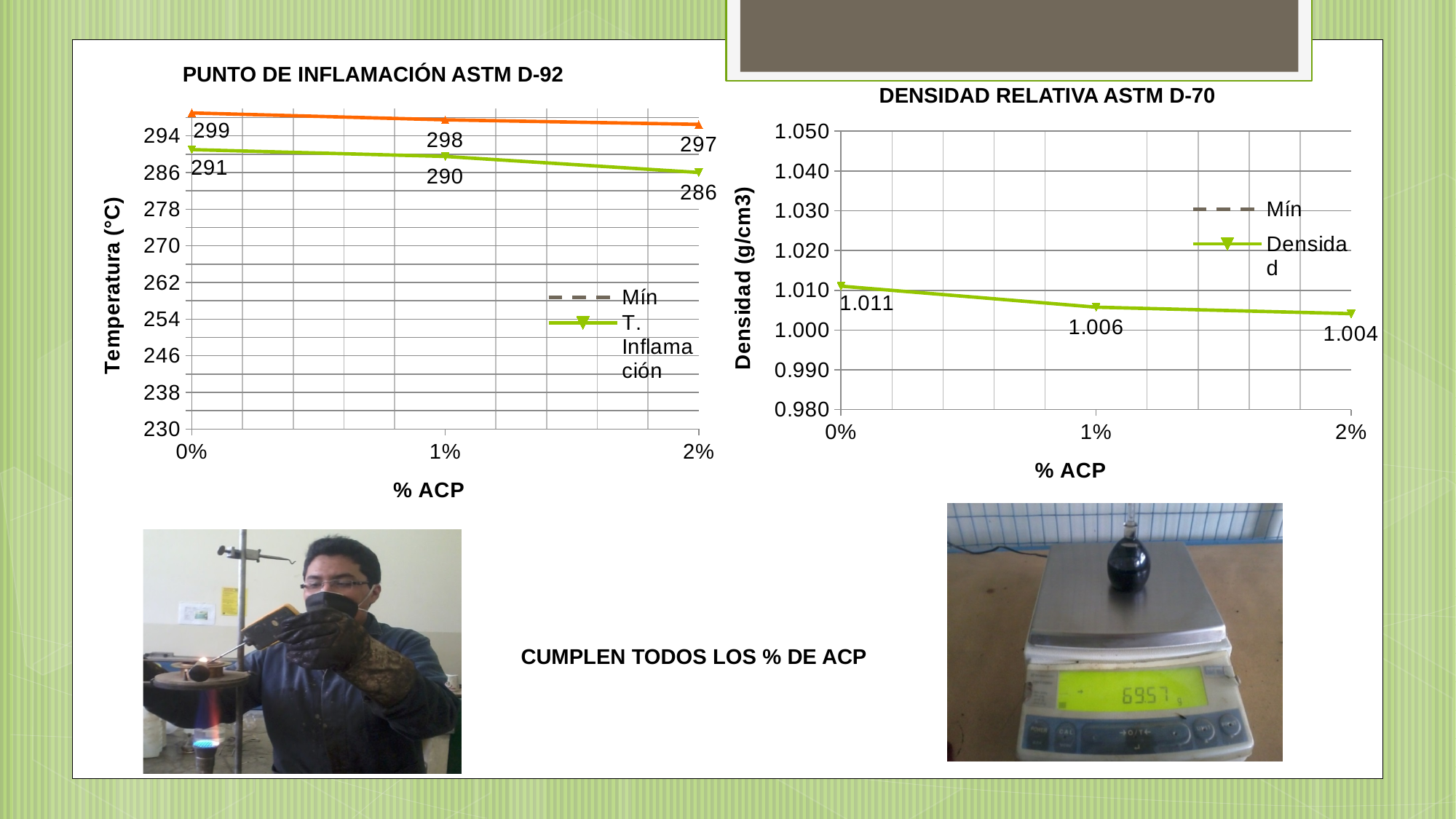
How many series does the legend of the PUNTO DE INFLAMACIÓN ASTM D-92 chart list? 2 In the PUNTO DE INFLAMACIÓN ASTM D-92 chart, what is the T. Inflamación value at 0% ACP? 291 In the DENSIDAD RELATIVA ASTM D-70 chart, what is the difference between the Densidad values at 0% and 2% ACP? 0.007 In the PUNTO DE INFLAMACIÓN ASTM D-92 chart, does the T. Inflamación series rise or fall as % ACP increases? fall In the PUNTO DE INFLAMACIÓN ASTM D-92 chart, what is the T. Inflamación value at 2% ACP? 286 In the DENSIDAD RELATIVA ASTM D-70 chart, at which % ACP is the Densidad value highest? 0% In the DENSIDAD RELATIVA ASTM D-70 chart, what is the Densidad value at 1% ACP? 1.006 In the PUNTO DE INFLAMACIÓN ASTM D-92 chart, what is the difference between the T. Inflamación values at 0% and 2% ACP? 5 In the PUNTO DE INFLAMACIÓN ASTM D-92 chart, at which % ACP is the T. Inflamación value lowest? 2% What type of chart is the DENSIDAD RELATIVA ASTM D-70 chart? line chart In the PUNTO DE INFLAMACIÓN ASTM D-92 chart, what is the value of the upper (orange) line at 1% ACP? 298 How many data points are plotted on the Densidad series in the DENSIDAD RELATIVA ASTM D-70 chart? 3